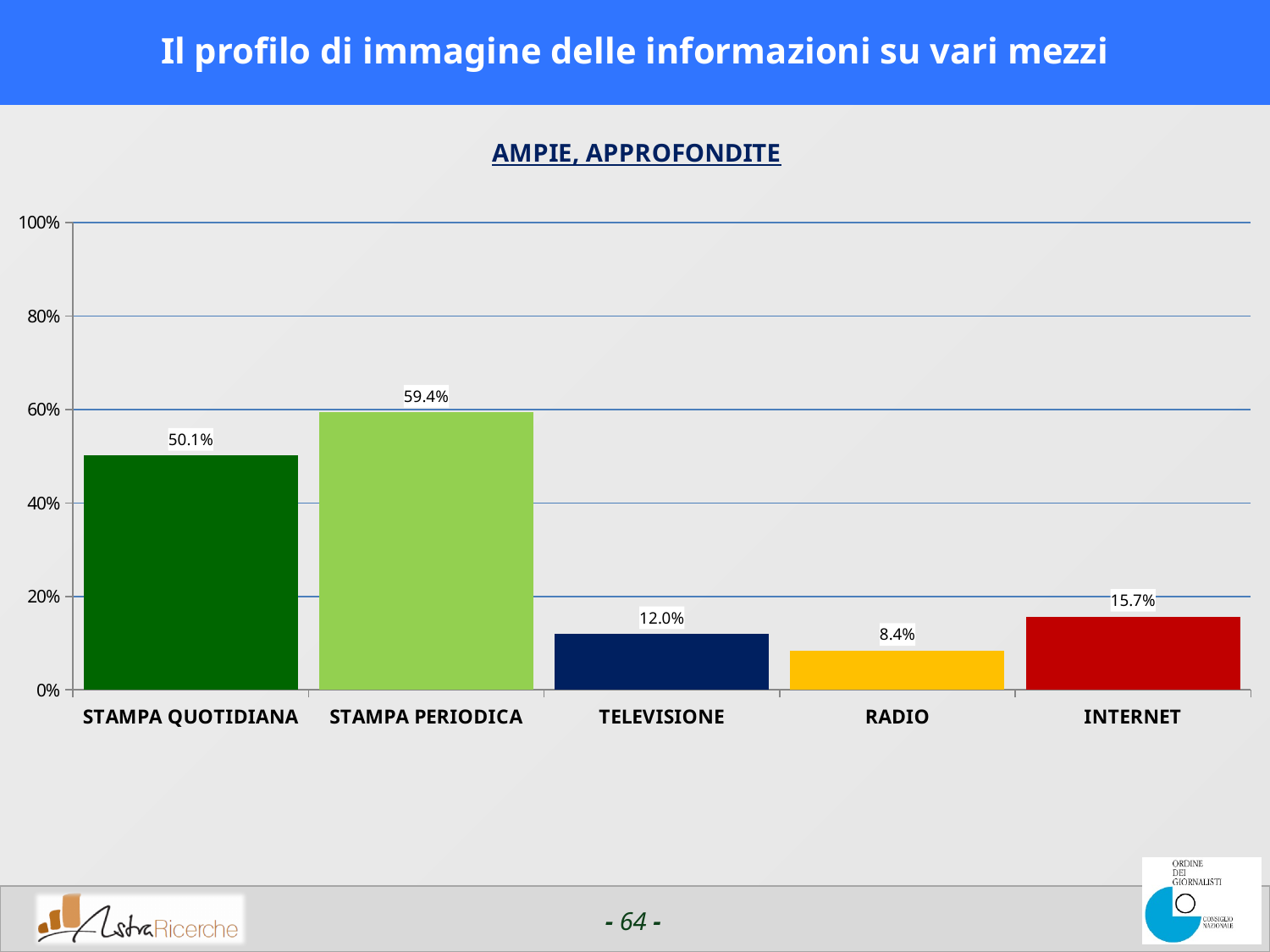
What kind of chart is shown on the slide? bar chart Which is larger, the value for TELEVISIONE or the value for INTERNET? INTERNET Is the value for STAMPA PERIODICA greater or less than 60%? less What is the difference between the values for TELEVISIONE and RADIO? 3.6% What is the difference between the values for STAMPA PERIODICA and STAMPA QUOTIDIANA? 9.3% What is the title shown above the chart? AMPIE, APPROFONDITE What is the value for STAMPA QUOTIDIANA? 50.1% Which category has the lowest value? RADIO How many categories are shown on the x axis? 5 What is the value for INTERNET? 15.7% What is the value for RADIO? 8.4% Which category has the highest value? STAMPA PERIODICA